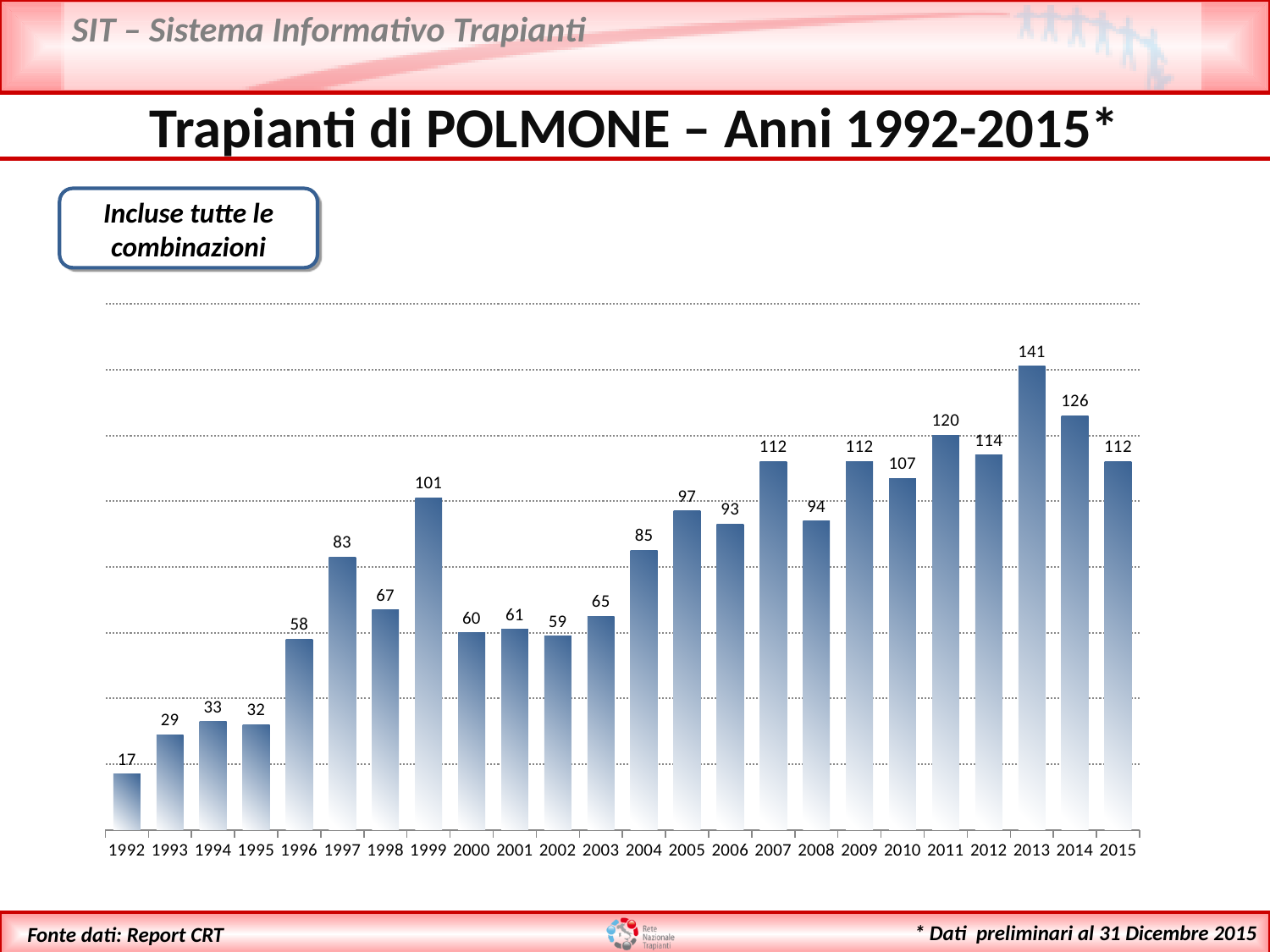
What is the value for 1992? 17 Do the values generally rise or fall from 1992 to 2013? rise What is the value for 2015? 112 Which is larger, the value for 1997 or the value for 1998? 1997 What type of chart is shown on the slide? bar chart Which year has the highest value? 2013 What is the difference between the values for 2011 and 2010? 13 How many years (categories) are plotted on the chart? 24 What is the title of the chart on the slide? Trapianti di POLMONE – Anni 1992-2015* Which year has the lowest value? 1992 What is the value for 1999? 101 What is the difference between the values for 2013 and 2014? 15